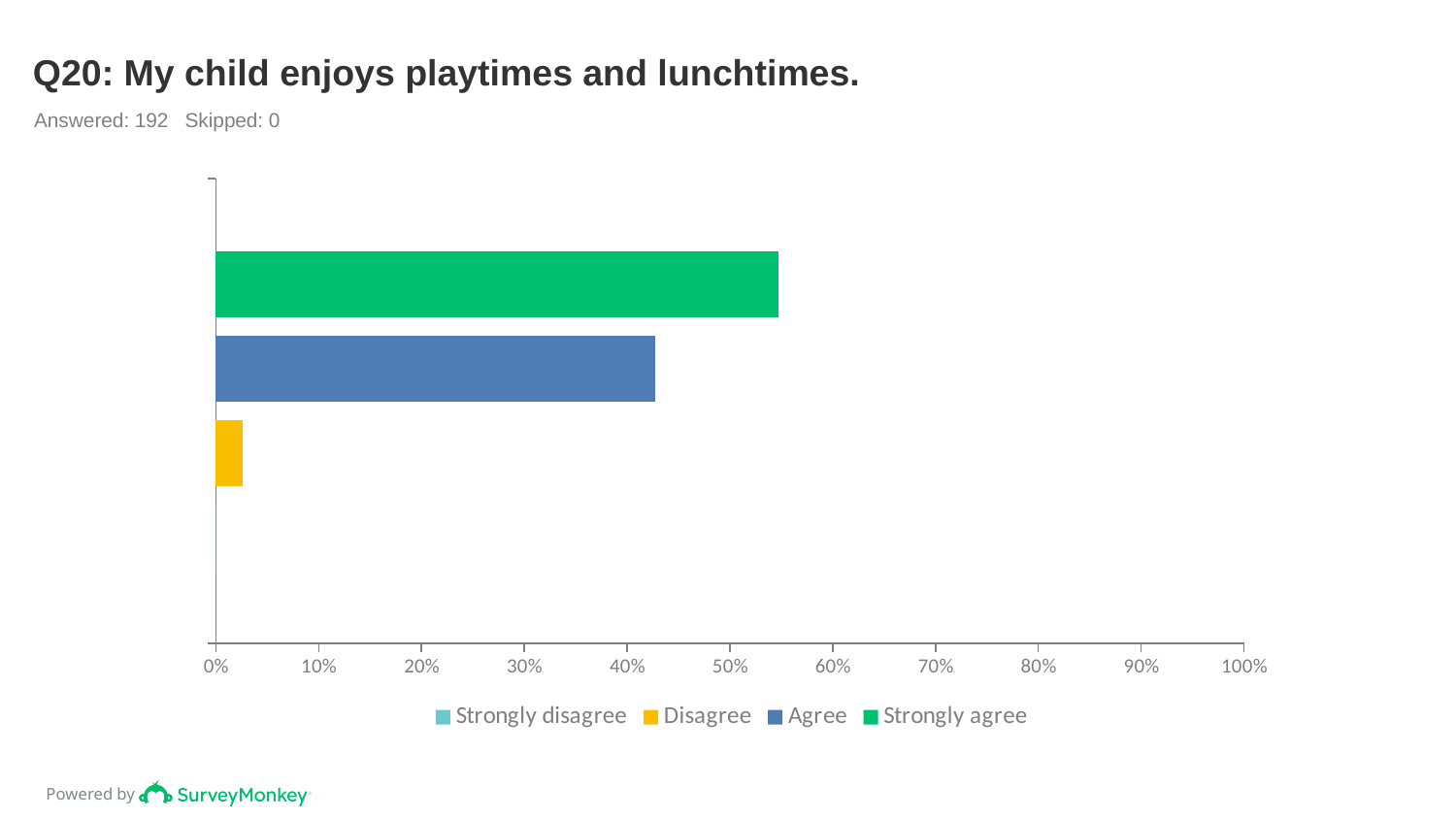
Is the value for Strongly agree greater or less than 60%? less Is the value for Disagree greater or less than 10%? less What is the title of the chart? Q20: My child enjoys playtimes and lunchtimes. Which is larger, the value for Agree or the value for Disagree? Agree Which is larger, the value for Strongly agree or the value for Agree? Strongly agree Is the value for Agree greater or less than 40%? greater How many respondents answered this question according to the slide? 192 Which response category has the highest value? Strongly agree How many series does the legend list? 4 What kind of chart is shown on the slide? bar chart